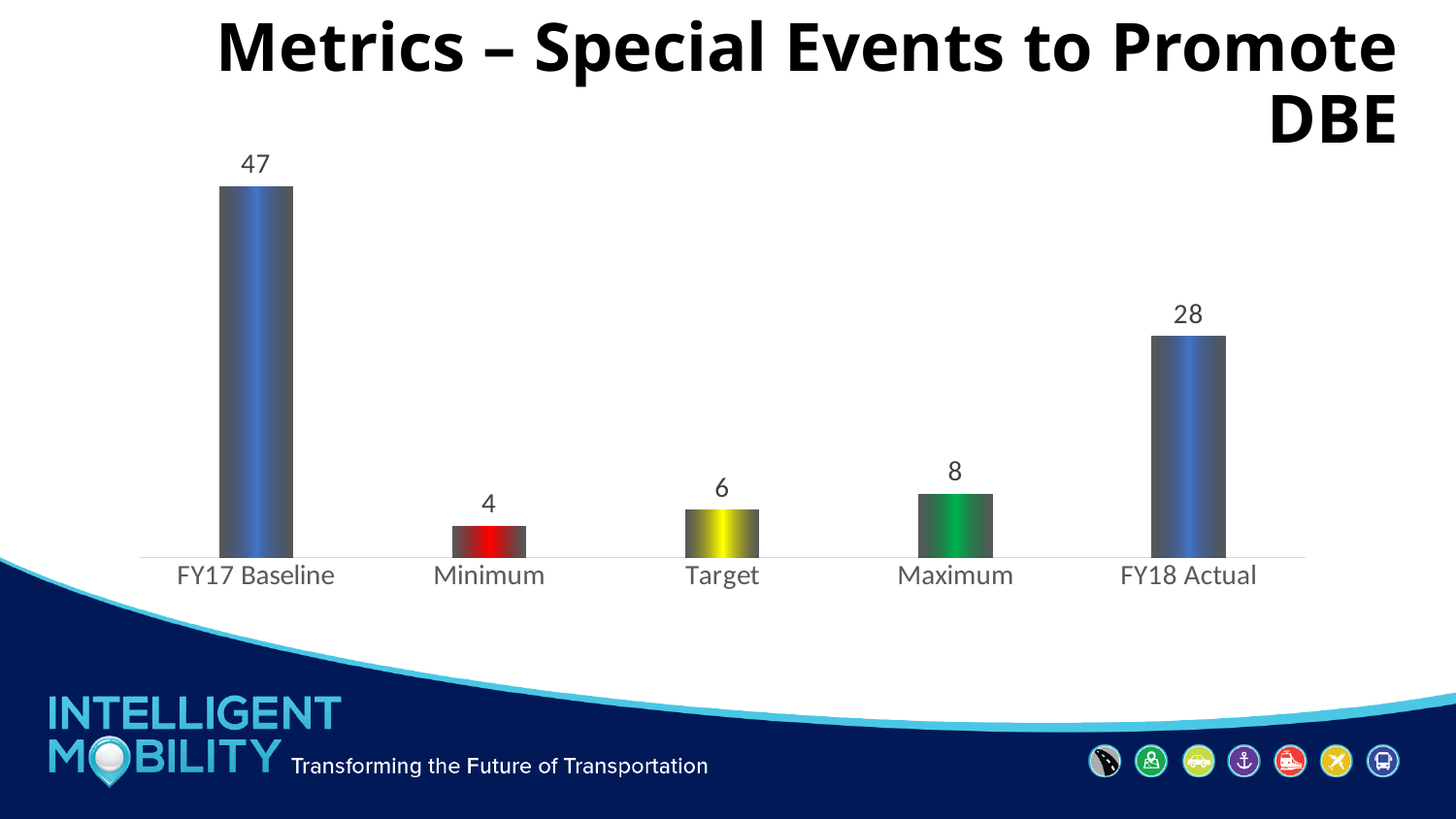
What is the value for FY17 Baseline? 47 What kind of chart is shown on the slide? Bar chart Which category has the highest value? FY17 Baseline What is the value for Minimum? 4 What colour is the Target bar? Yellow How many categories are shown on the chart? 5 Which is larger, FY18 Actual or Maximum? FY18 Actual What is the difference between FY17 Baseline and FY18 Actual? 19 Which category has the lowest value? Minimum What is the value for FY18 Actual? 28 What is the value for Target? 6 What is the difference between Maximum and Minimum? 4